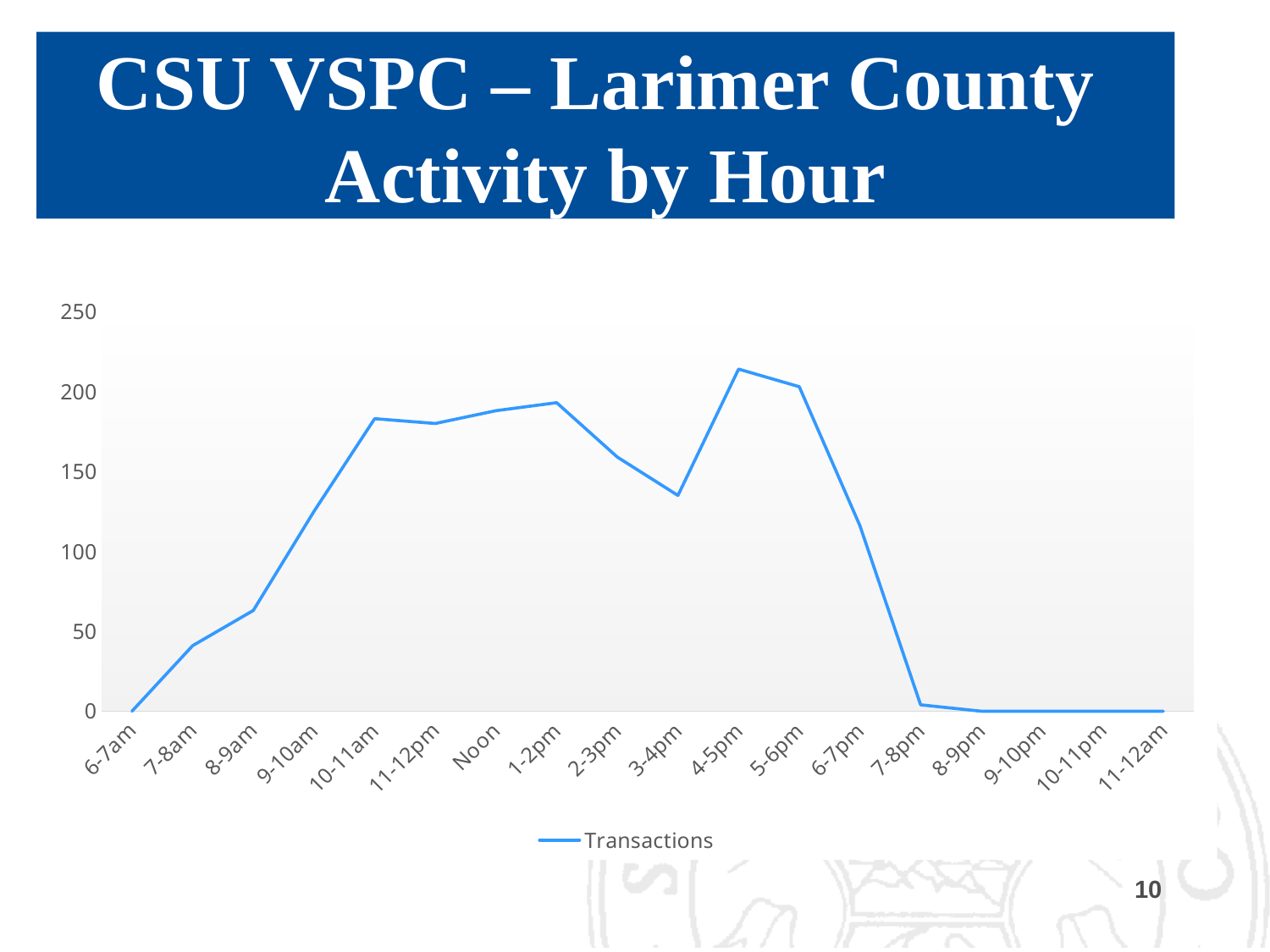
Is the value for 10-11am greater or less than 150? greater Is the value for 7-8pm greater or less than 50? less How many series does the legend list? 1 How many hourly categories are shown on the x axis? 18 Do the values rise or fall from 6-7am to 10-11am? rise Which is larger, the value for 4-5pm or the value for 3-4pm? 4-5pm Which is larger, the value for 1-2pm or the value for 2-3pm? 1-2pm Is the value for 3-4pm greater or less than 150? less What is the value for 6-7am? 0 Which hour has the highest number of transactions? 4-5pm What is the name of the series shown in the legend? Transactions What kind of chart is shown on the slide? line chart